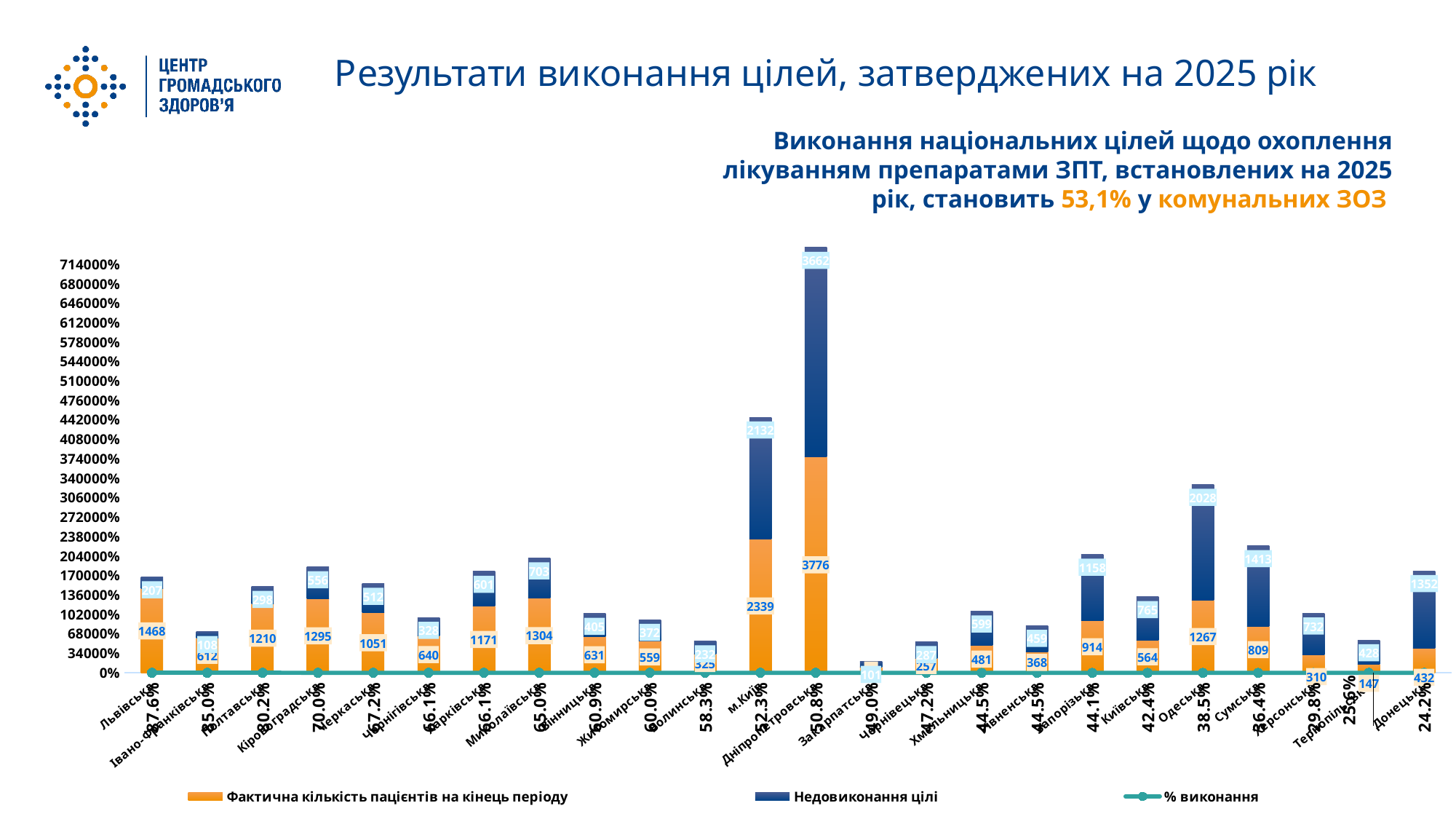
What is the value of 'Фактична кількість пацієнтів на кінець періоду' for Дніпропетровська? 3776 What is the difference between the 'Фактична кількість пацієнтів' values for Миколаївська (1304) and Харківська (1171)? 133 Which region has the highest value of 'Фактична кількість пацієнтів на кінець періоду'? Дніпропетровська What is the total of the stacked bar for Львівська (1468 + 207)? 1675 What is the value of 'Фактична кількість пацієнтів на кінець періоду' for Львівська? 1468 What kind of chart is shown on the slide? combination bar and line chart Which has the larger 'Недовиконання цілі' value, Одеська or Сумська? Одеська What is the value of 'Недовиконання цілі' for Одеська? 2028 Which region has the lowest value of 'Недовиконання цілі'? Закарпатська How many regions are shown on the x axis of the chart? 24 According to the chart title, what percentage of the national targets for ЗПТ treatment coverage was achieved in комунальних ЗОЗ? 53,1% How many series does the legend list? 3